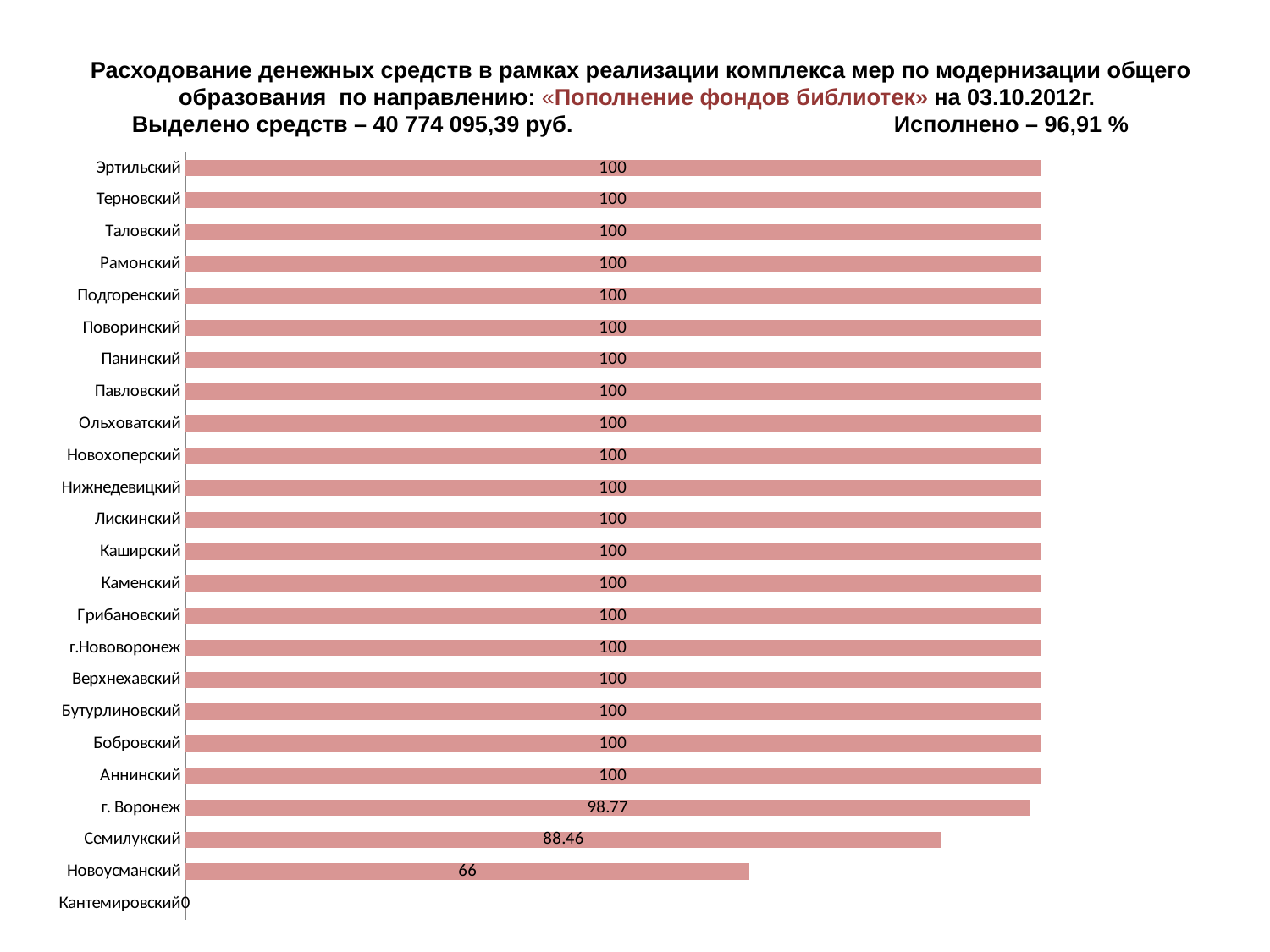
How many categories have a value of 100? 20 Which is larger, the value for Семилукский or the value for Новоусманский? Семилукский What is the value for Семилукский? 88.46 What is the difference between the values for Аннинский and Новоусманский? 34 How many categories are shown on the chart? 24 Which category has the lowest value? Кантемировский What is the value for Новоусманский? 66 According to the slide heading, what is the overall execution percentage (Исполнено)? 96,91 % What is the value for г. Воронеж? 98.77 What kind of chart is shown on the slide? bar chart What is the value for Кантемировский? 0 What is the difference between the values for г. Воронеж and Семилукский? 10.31